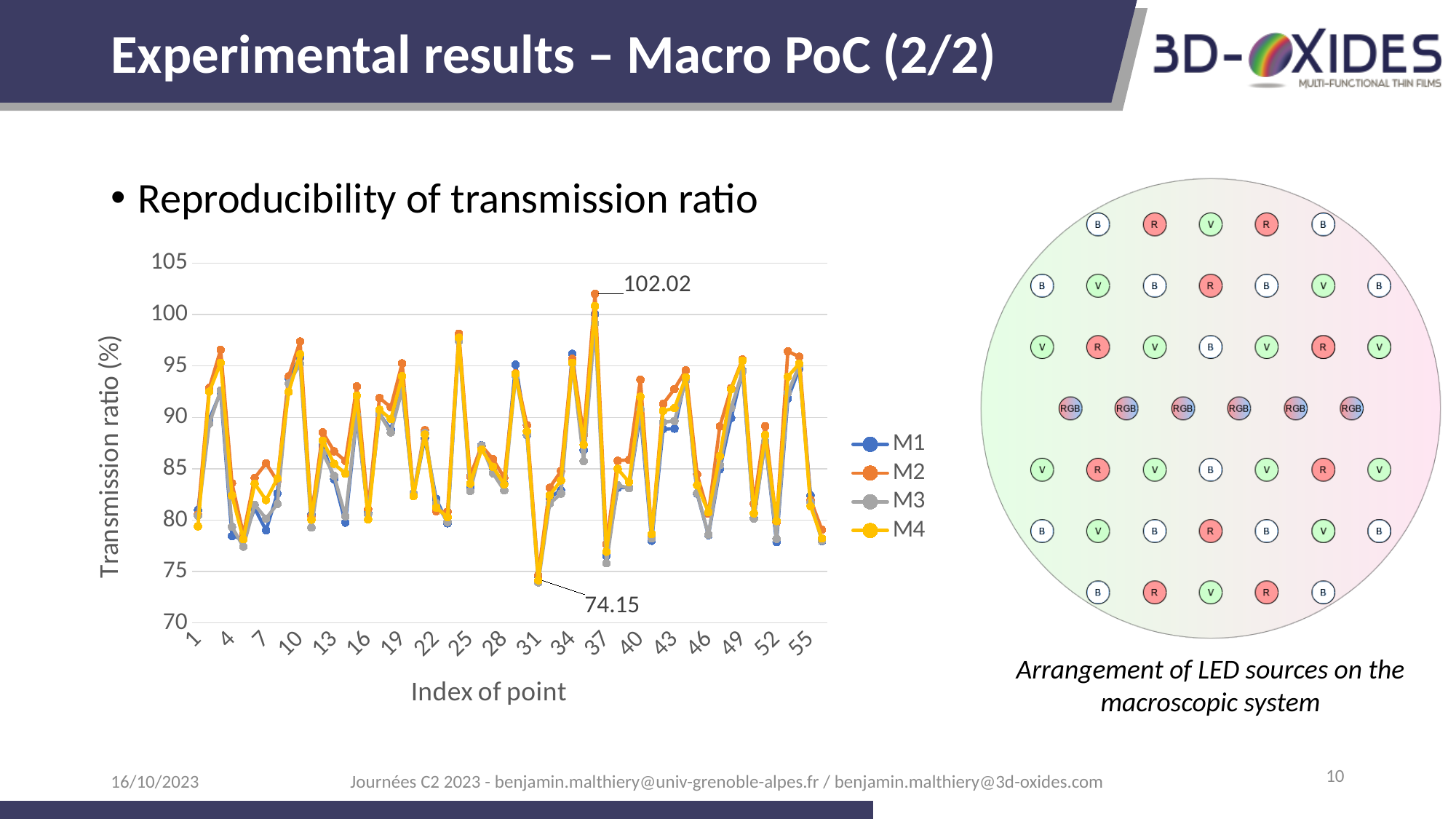
What are the series names listed in the chart legend? M1, M2, M3, M4 Is the peak value of the M2 series near index 37 greater or less than 100? greater How many series does the legend of the chart list? 4 What is the lowest transmission ratio value labelled on the chart? 74.15 Which is larger on the chart: the labelled value 102.02 or the labelled value 74.15? 102.02 What kind of chart is shown on the slide? line chart Is the lowest value on the chart, near index 31, greater or less than 75? less What is the title of the vertical axis of the chart? Transmission ratio (%) What is the difference between the highest labelled value (102.02) and the lowest labelled value (74.15) on the chart? 27.87 Which series reaches the peak value of 102.02 on the chart? M2 What is the highest transmission ratio value labelled on the chart? 102.02